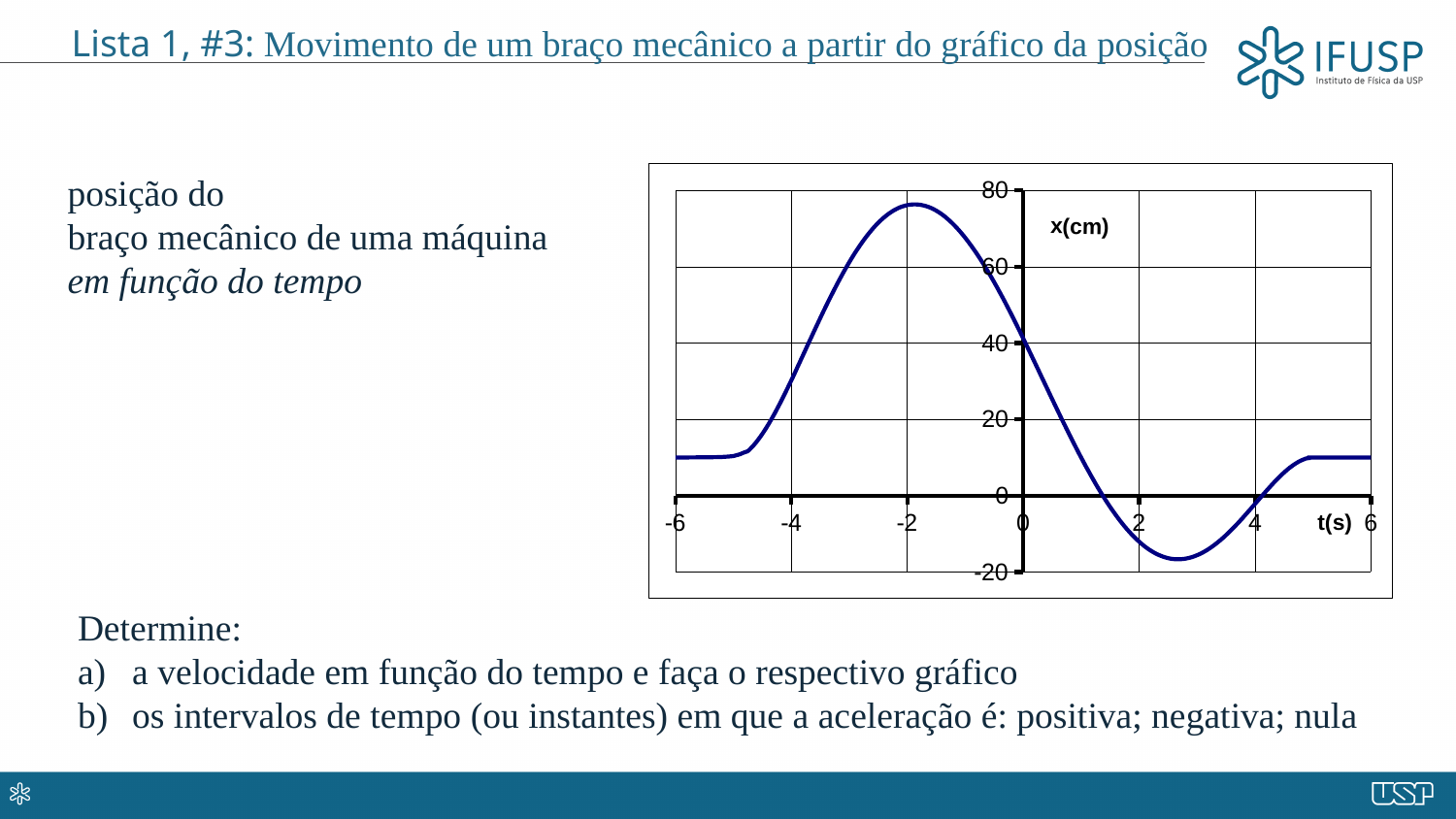
Is the maximum value of x on the chart greater or less than 60? greater Is the value of x at t = 3 s greater or less than 0? less Does the value of x rise or fall between t = -4 s and t = -2 s? rise Is the value of x at t = -6 s greater or less than 20? less What kind of chart is shown on the slide? line chart Which is larger, the value of x at t = -2 s or at t = 2 s? t = -2 s What is the label of the vertical axis of the chart? x(cm) Does the value of x rise or fall between t = 0 s and t = 2 s? fall What is the label of the horizontal axis of the chart? t(s)